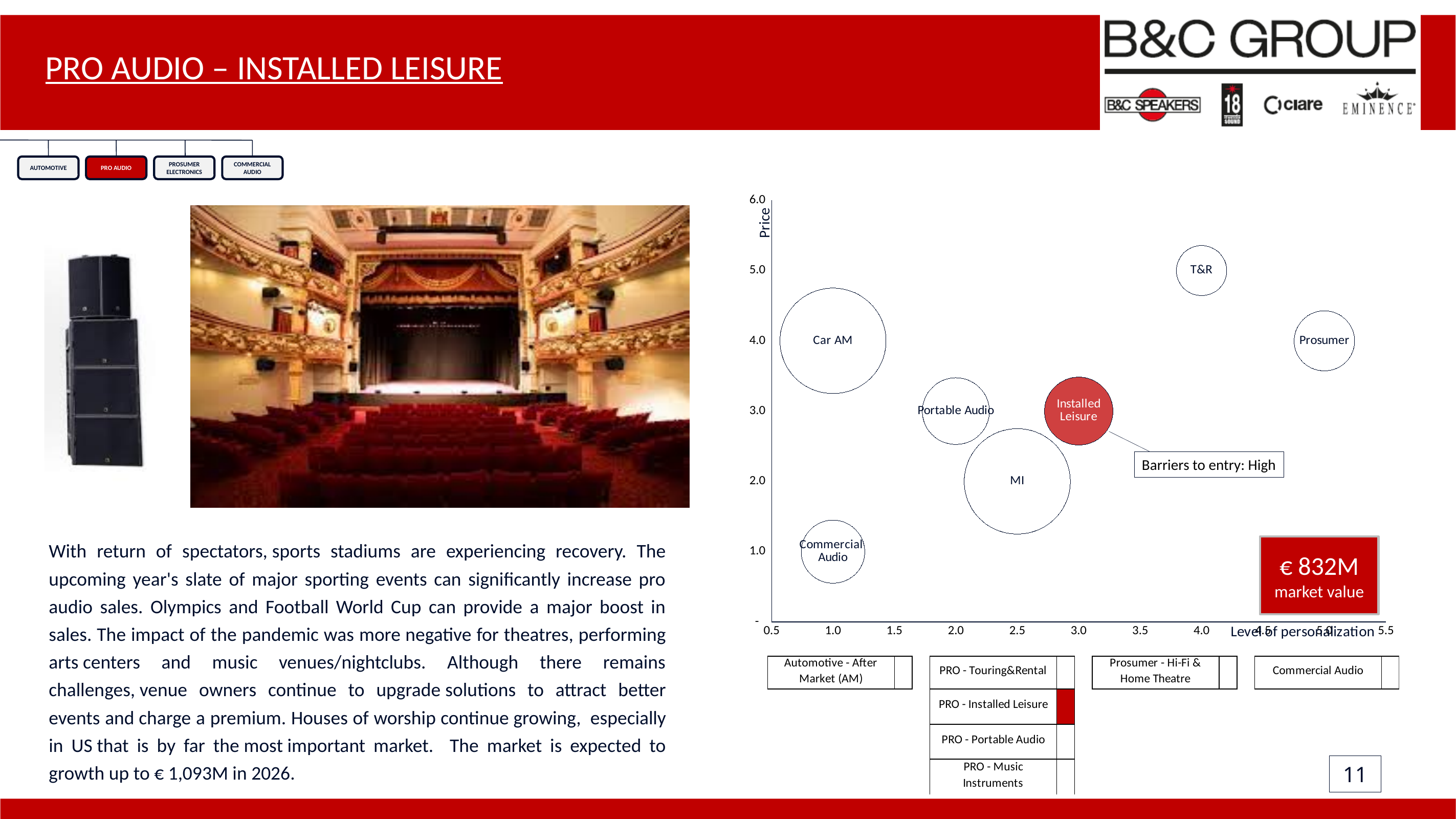
Which has a higher price, T&R or MI? T&R Is the level of personalization for Car AM greater or less than 2.0? less Is the price value for Installed Leisure greater or less than 2.0? greater Which bubble in the chart is highlighted in red? Installed Leisure Which has a higher level of personalization, Installed Leisure or Portable Audio? Installed Leisure How many bubbles (segments) are plotted in the chart? 7 Is the price value for Commercial Audio greater or less than 2.0? less What kind of chart is shown on the right of the slide? bubble chart Which segment has the lowest price in the chart? Commercial Audio Which segment has the highest level of personalization in the chart? Prosumer Which segment has the highest price in the chart? T&R What is the label of the vertical axis of the chart? Price